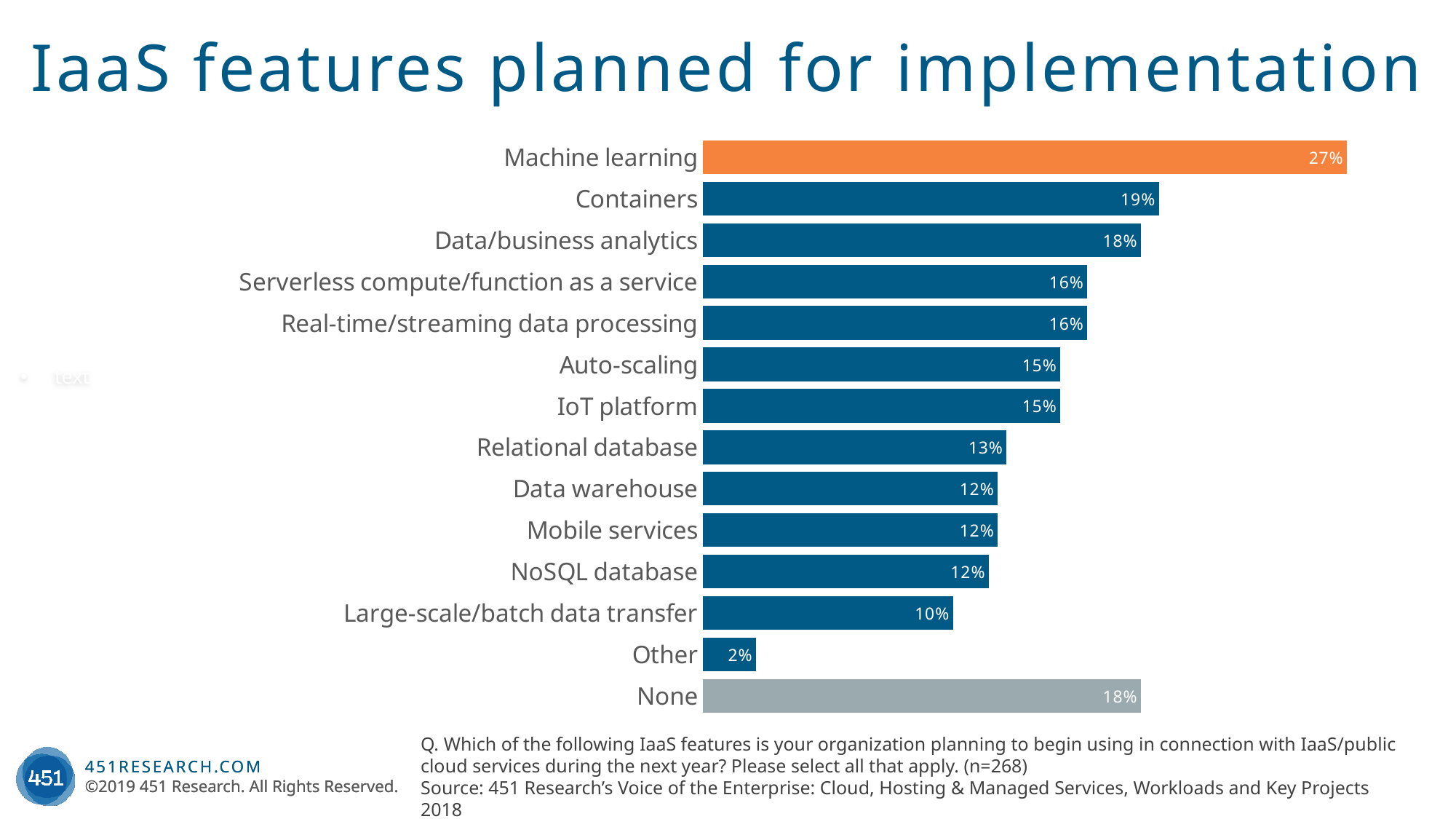
Which IaaS feature has the highest percentage planned for implementation? Machine learning What is the difference between the values for Auto-scaling and Other? 13% What kind of chart is shown on the slide? Bar chart Which category has the lowest value on the chart? Other Which bar is coloured orange on the chart? Machine learning What is the value shown for Containers? 19% Which has a higher value, Relational database or Data warehouse? Relational database How many categories are shown on the chart? 14 What percentage is shown for Large-scale/batch data transfer? 10% What is the difference between the values for Machine learning and Containers? 8% What percentage of respondents plan to implement Machine learning? 27% What is the value for the None category? 18%